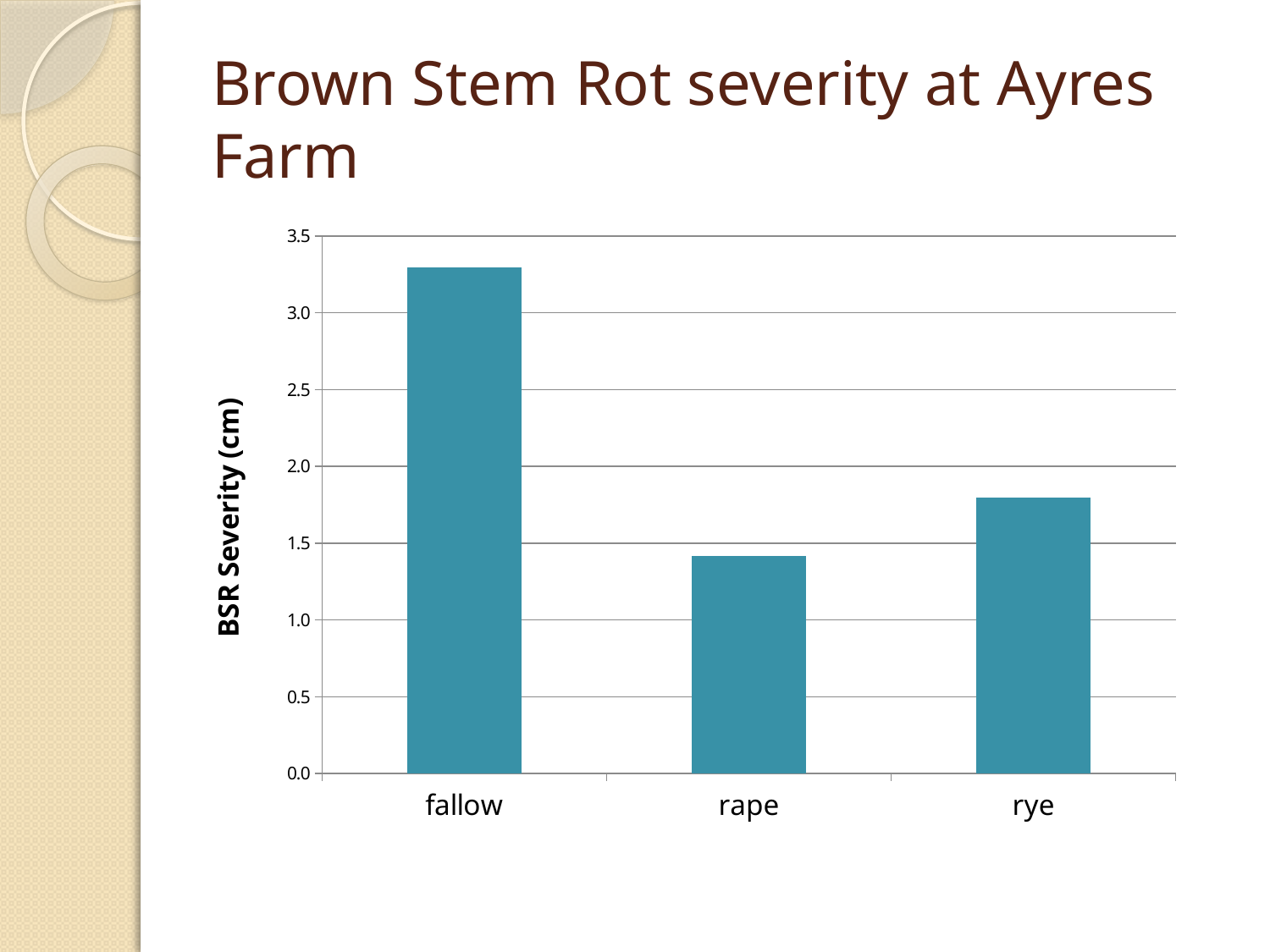
Which has a higher BSR severity, rape or rye? rye Is the BSR severity for rye greater or less than 1.5? greater What kind of chart is shown on the slide? bar chart Which category has the highest BSR severity? fallow Is the BSR severity for rye greater or less than 2.0? less Is the BSR severity for rape greater or less than 1.5? less Which category has the lowest BSR severity? rape What is the title of the slide containing the chart? Brown Stem Rot severity at Ayres Farm What is the label of the y axis of the chart? BSR Severity (cm) Which has a higher BSR severity, fallow or rye? fallow How many categories are shown on the x axis of the chart? 3